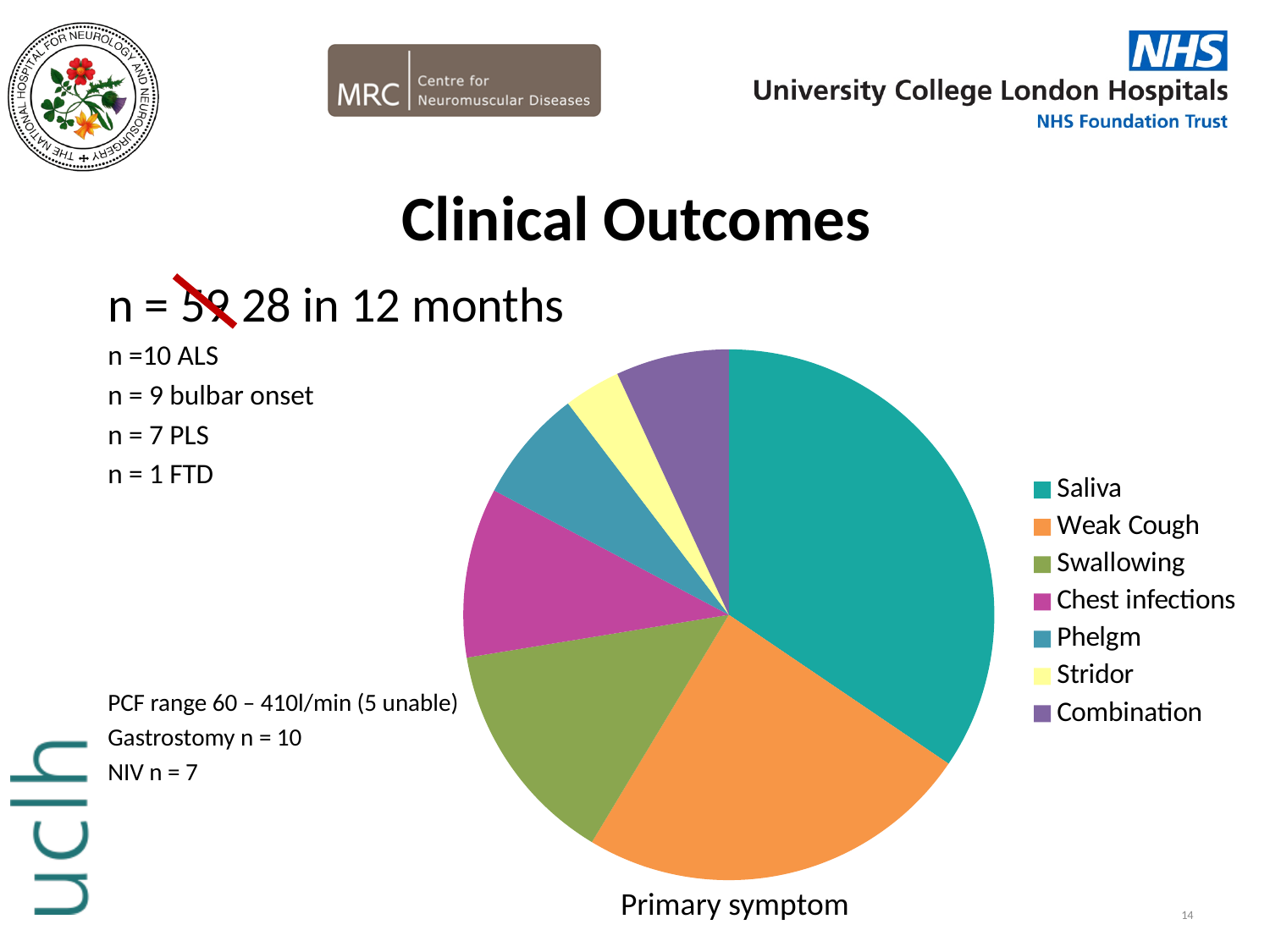
What kind of chart is shown on the slide? pie chart What is the title of the pie chart? Primary symptom Which category has the smallest slice of the pie chart? Stridor Which slice is larger, Swallowing or Phelgm? Swallowing Which slice is larger, Weak Cough or Combination? Weak Cough Which slice is larger, Chest infections or Stridor? Chest infections What colour is the Saliva slice in the pie chart? teal How many categories does the pie chart's legend list? 7 Which category has the largest slice of the pie chart? Saliva